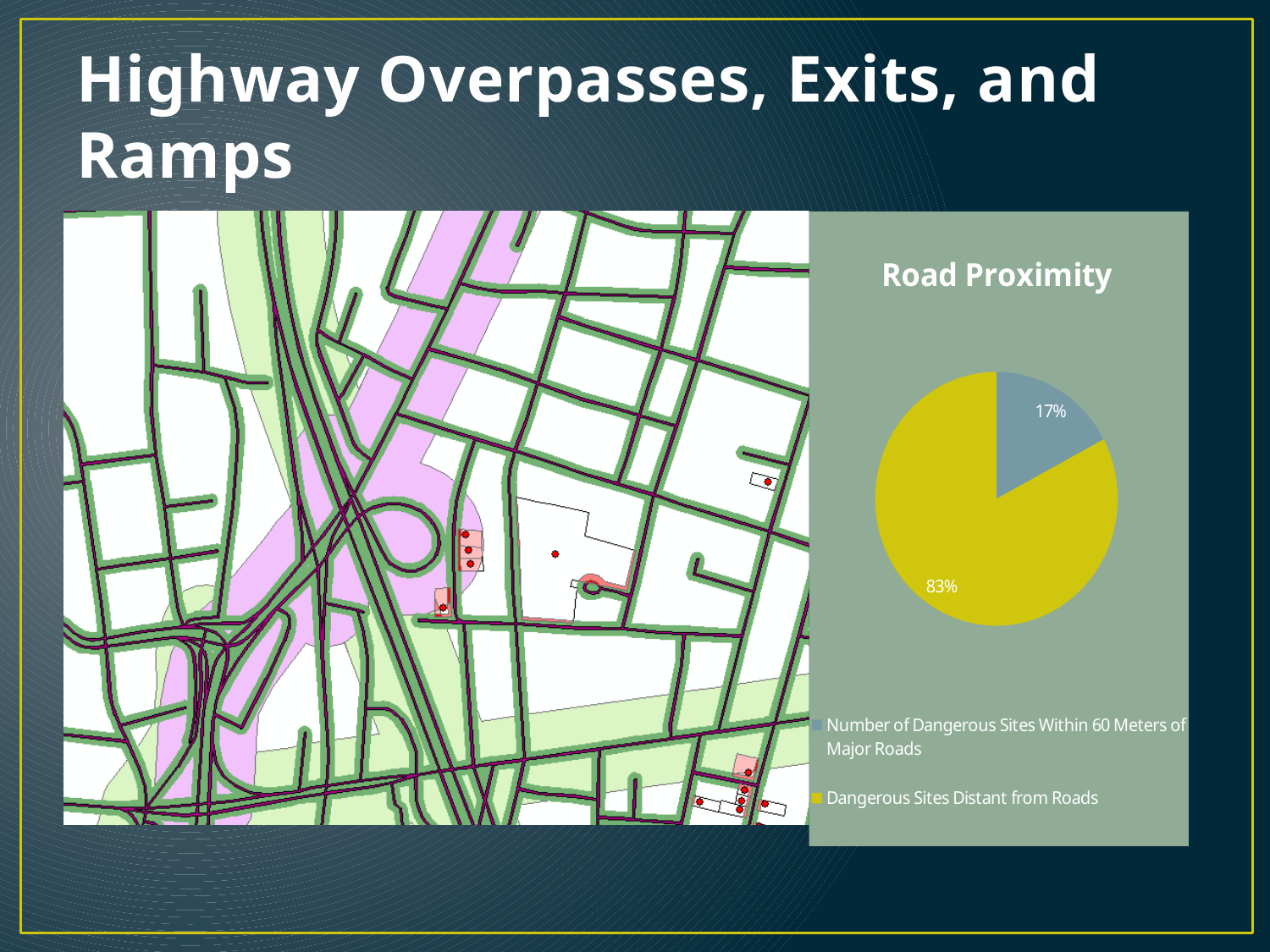
Which is larger in the pie chart: the share of sites within 60 meters of major roads or the share of sites distant from roads? Dangerous Sites Distant from Roads What percentage of the pie chart is labelled for Number of Dangerous Sites Within 60 Meters of Major Roads? 17% What percentage of the pie chart is labelled for Dangerous Sites Distant from Roads? 83% Which slice of the pie chart is the smallest? Number of Dangerous Sites Within 60 Meters of Major Roads How many entries does the pie chart's legend list? 2 What colour is the slice for Dangerous Sites Distant from Roads in the pie chart? yellow What is the difference in percentage points between the two slices of the pie chart? 66 What kind of chart is shown on the right of the slide? pie chart How many slices does the pie chart have? 2 What is the title of the pie chart? Road Proximity Which slice of the pie chart is the largest? Dangerous Sites Distant from Roads